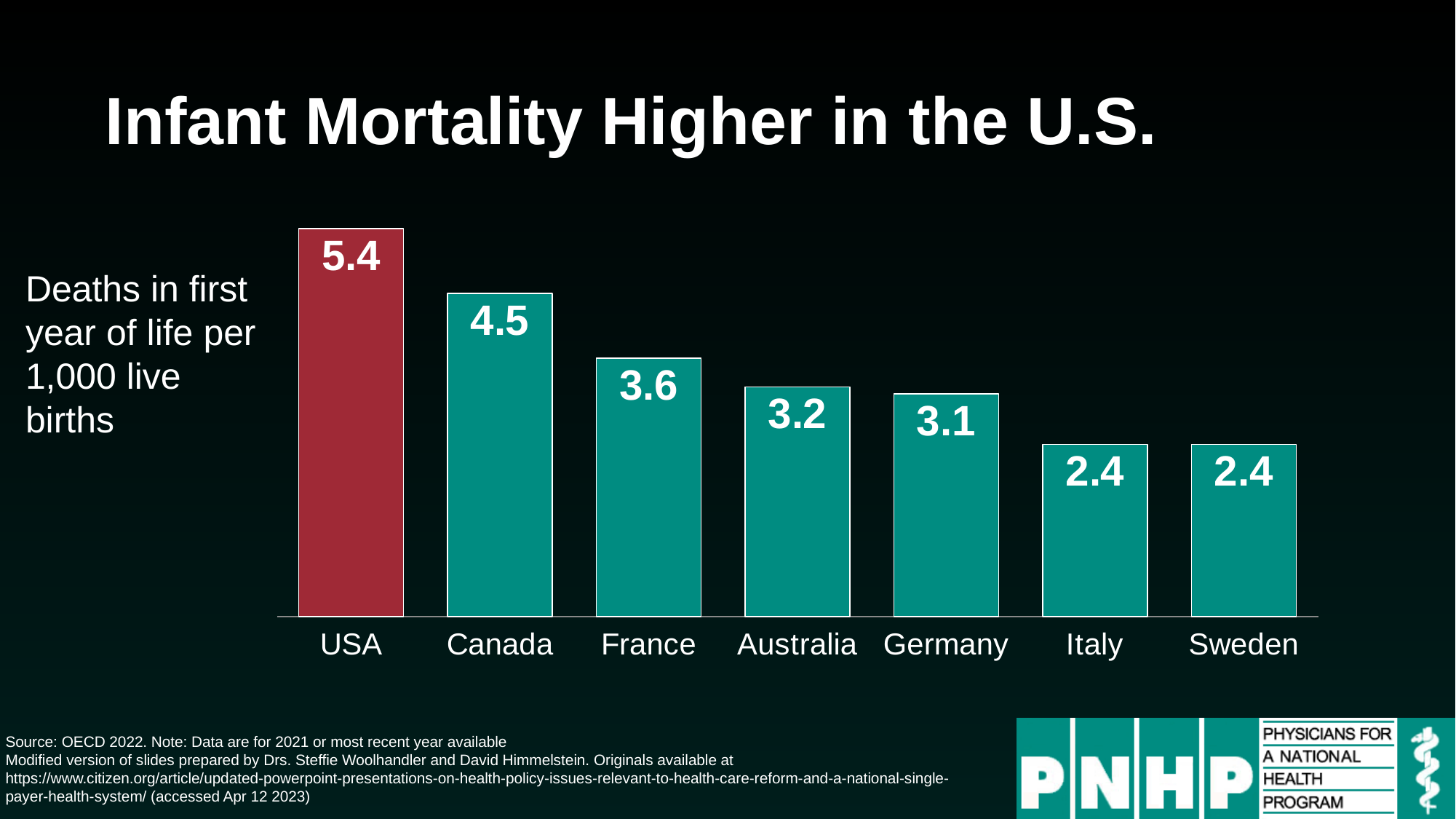
What is the lowest value shown on the chart? 2.4 What is the value shown for Germany? 3.1 What is the difference between the values for the USA and Sweden? 3.0 Do the values rise or fall moving from left to right across the chart? Fall How many countries are shown on the chart? 7 What is the infant mortality rate shown for the USA? 5.4 What kind of chart is shown on the slide? Bar chart Which country has the highest infant mortality rate on the chart? USA Which has a higher value, France or Australia? France What is the value shown for Canada? 4.5 Which bar is coloured differently from the others? USA What is the difference between the values for Canada and France? 0.9